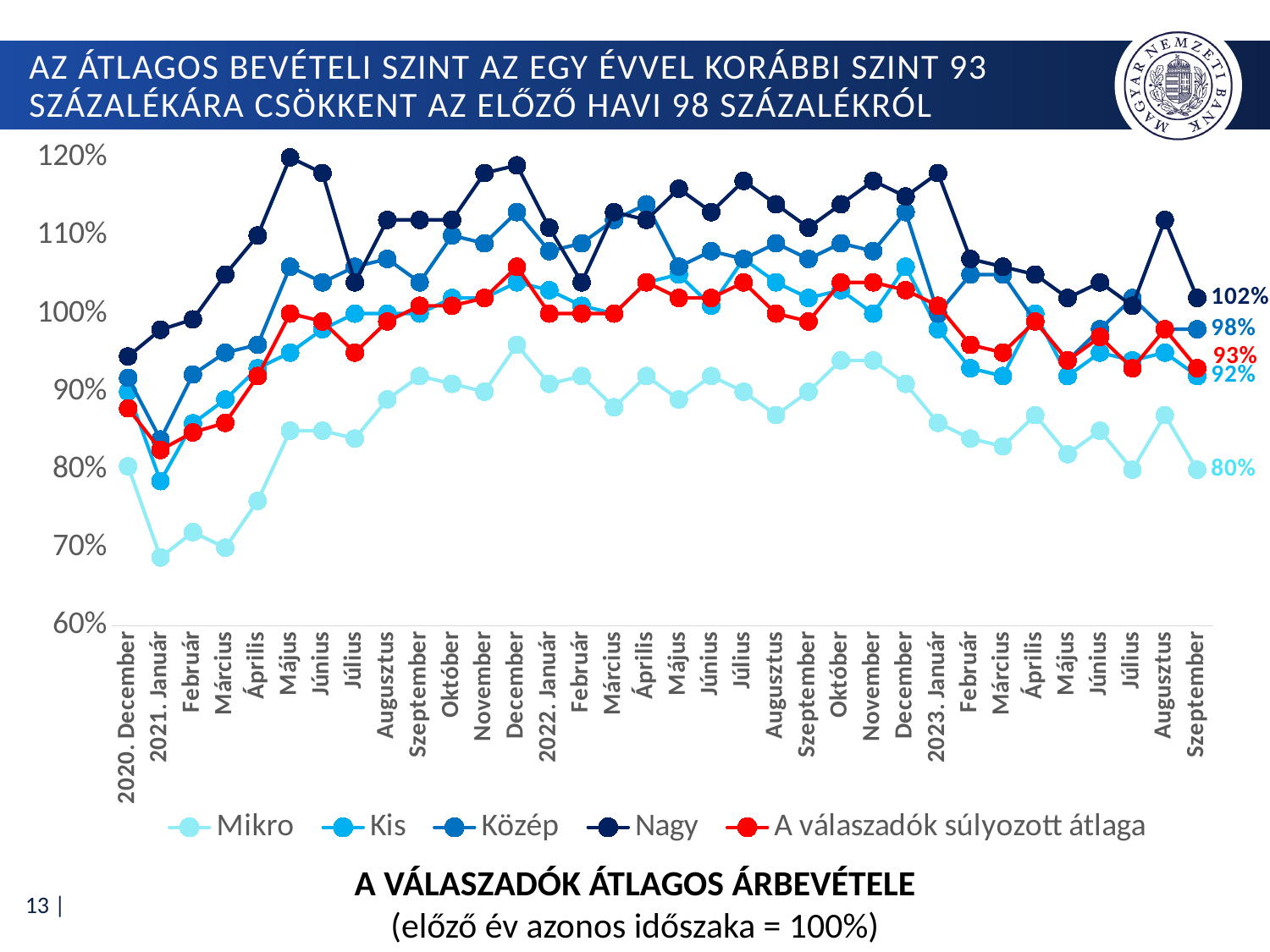
What is the value for Nagy in 2023 Szeptember? 102% Is the value for Nagy in 2021 Május greater or less than 110%? greater Is the value for Mikro in 2021 Január greater or less than 70%? less Which series has the highest value in 2023 Szeptember? Nagy What is the value for Kis in 2023 Szeptember? 92% What type of chart is shown on the slide? line chart Which series has the lowest value in 2023 Szeptember? Mikro What is the difference between the Nagy and Mikro values in 2023 Szeptember? 22 percentage points What is the value for Közép in 2023 Szeptember? 98% What is the value for Mikro in 2023 Szeptember? 80% How many series does the legend list? 5 What is the value for A válaszadók súlyozott átlaga in 2023 Szeptember? 93%